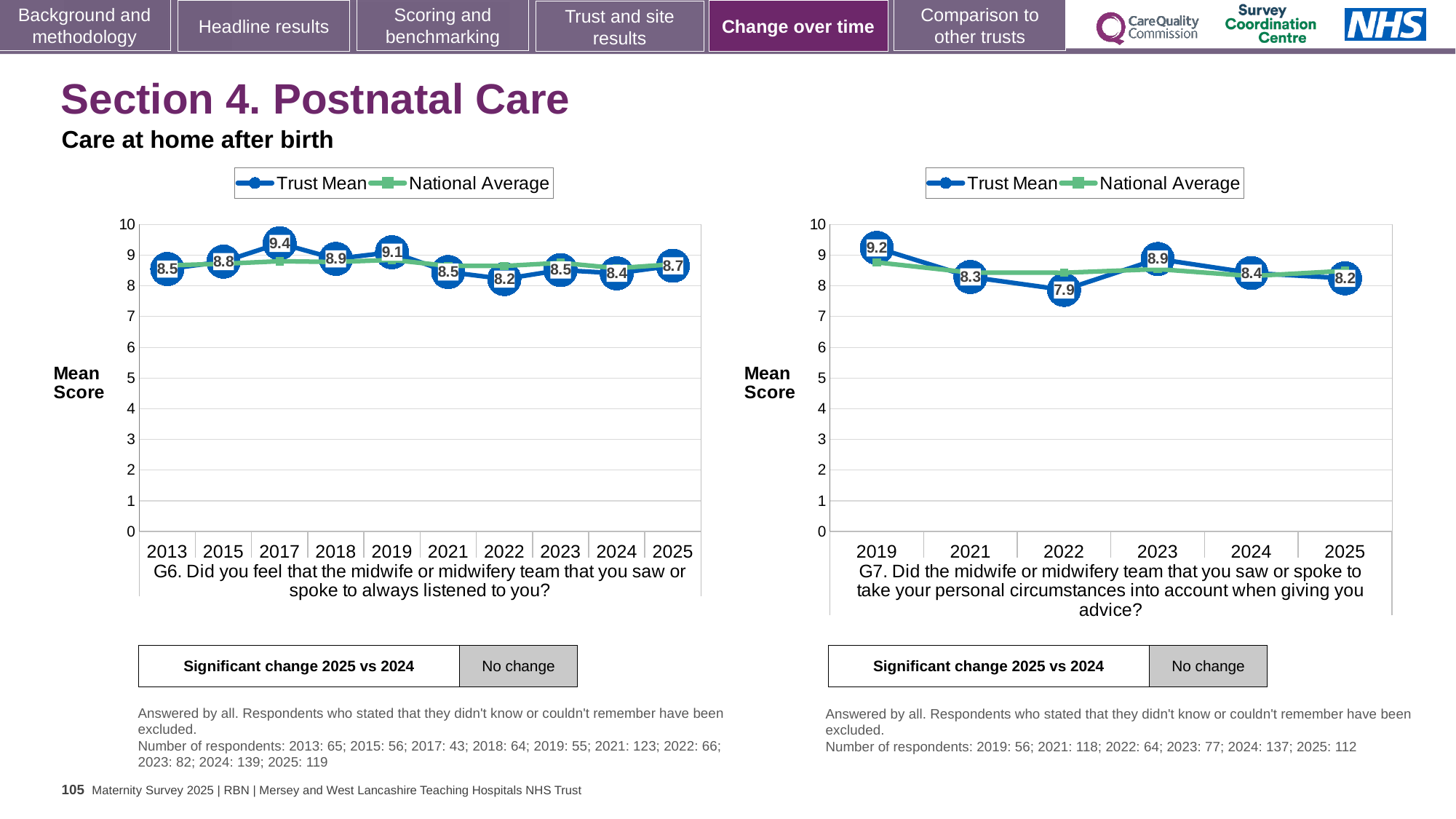
In the G7 chart on the right, which year has the lowest Trust Mean score? 2022 In the G6 chart on the left, what is the Trust Mean score for 2017? 9.4 What type of chart is the G6 chart on the left? Line chart In the G7 chart on the right, what is the difference between the Trust Mean scores for 2019 and 2025? 1.0 In the G6 chart on the left, which year has the lowest Trust Mean score? 2022 In the G7 chart on the right, which is larger, the Trust Mean score for 2023 or for 2024? 2023 In the G7 chart on the right, what does the box below the chart say for 'Significant change 2025 vs 2024'? No change In the G7 chart on the right, what is the Trust Mean score for 2019? 9.2 In the G7 chart on the right, how many series does the legend list? 2 In the G6 chart on the left, what is the difference between the Trust Mean scores for 2017 and 2022? 1.2 In the G6 chart on the left, is the Trust Mean score for 2025 greater or less than 8? greater In the G6 chart on the left, how many years are plotted on the x axis? 10